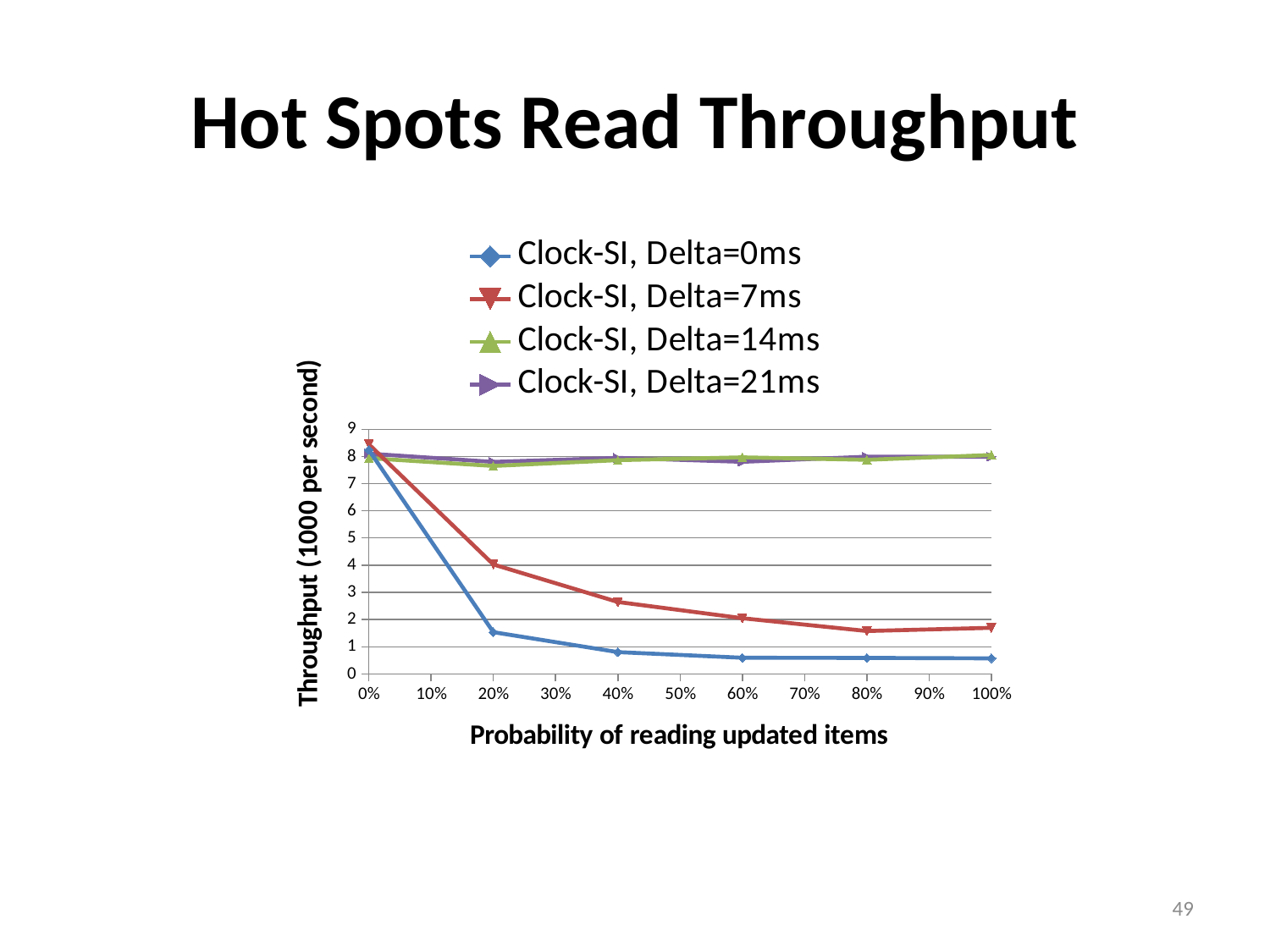
Does the throughput for Clock-SI, Delta=0ms rise or fall as the probability of reading updated items increases? fall Which series has the lowest throughput at 100%? Clock-SI, Delta=0ms Is the value for Clock-SI, Delta=0ms at 20% greater or less than 2? less At 100%, which is larger: the value for Clock-SI, Delta=7ms or Clock-SI, Delta=0ms? Clock-SI, Delta=7ms Is the value for Clock-SI, Delta=21ms at 60% greater or less than 7? greater What is the title of the y axis? Throughput (1000 per second) Is the value for Clock-SI, Delta=0ms at 100% greater or less than 1? less How many data points are plotted for the Clock-SI, Delta=0ms series? 6 How many series does the legend list? 4 What is the title of the x axis? Probability of reading updated items What kind of chart is shown on the slide? line chart